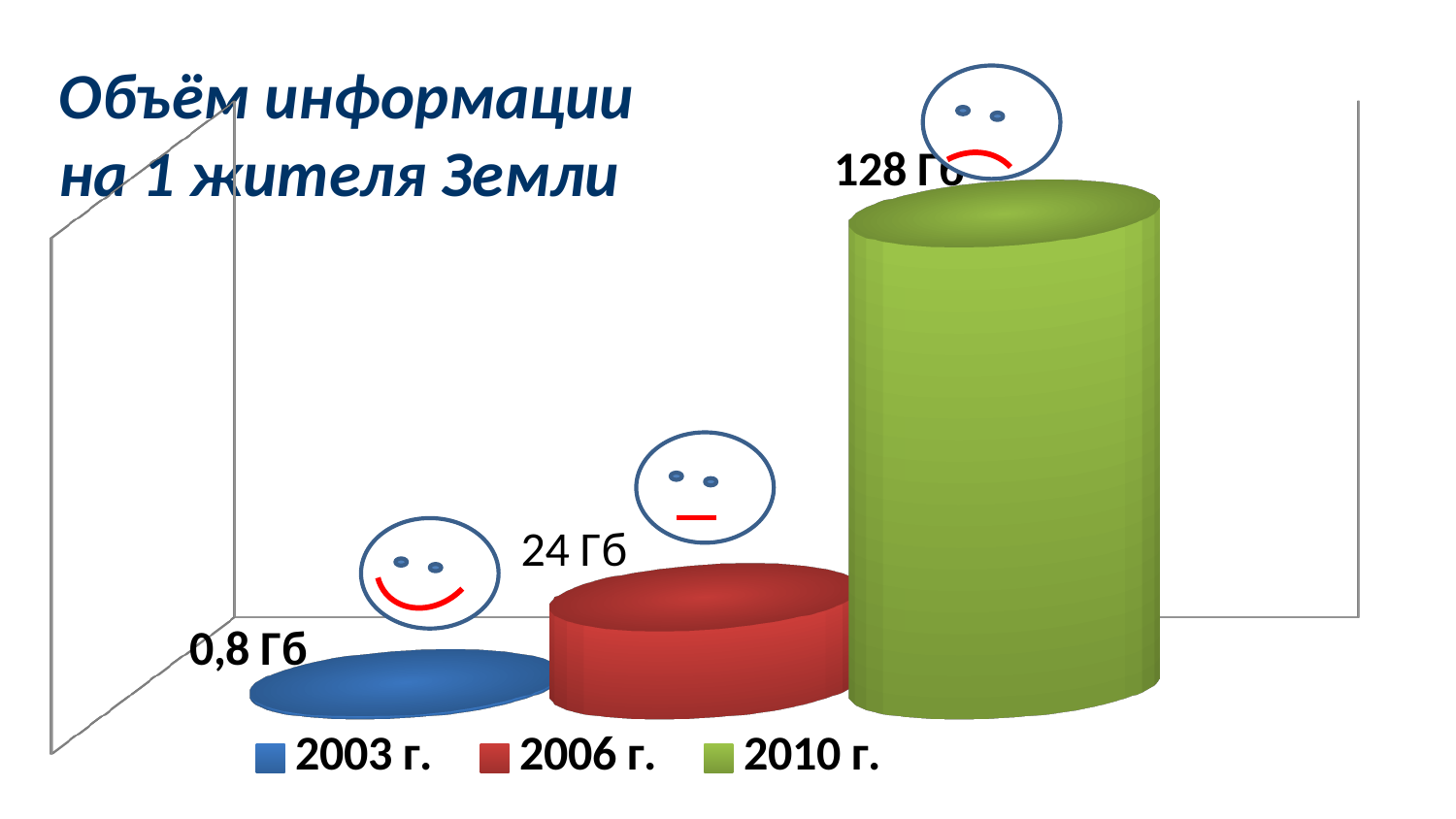
What is the value shown for 2003 г.? 0,8 Гб Do the values rise or fall from 2003 г. to 2010 г.? Rise How many entries does the legend list? 3 Which year has the lowest value? 2003 г. Which year has the highest value? 2010 г. What is the difference between the values for 2010 г. and 2006 г.? 104 Гб What is the value shown for 2006 г.? 24 Гб Which is larger, the value for 2006 г. or the value for 2003 г.? 2006 г. How many bars are plotted on the chart? 3 What kind of chart is shown on the slide? Bar chart What is the difference between the values for 2006 г. and 2003 г.? 23,2 Гб What is the value shown for 2010 г.? 128 Гб